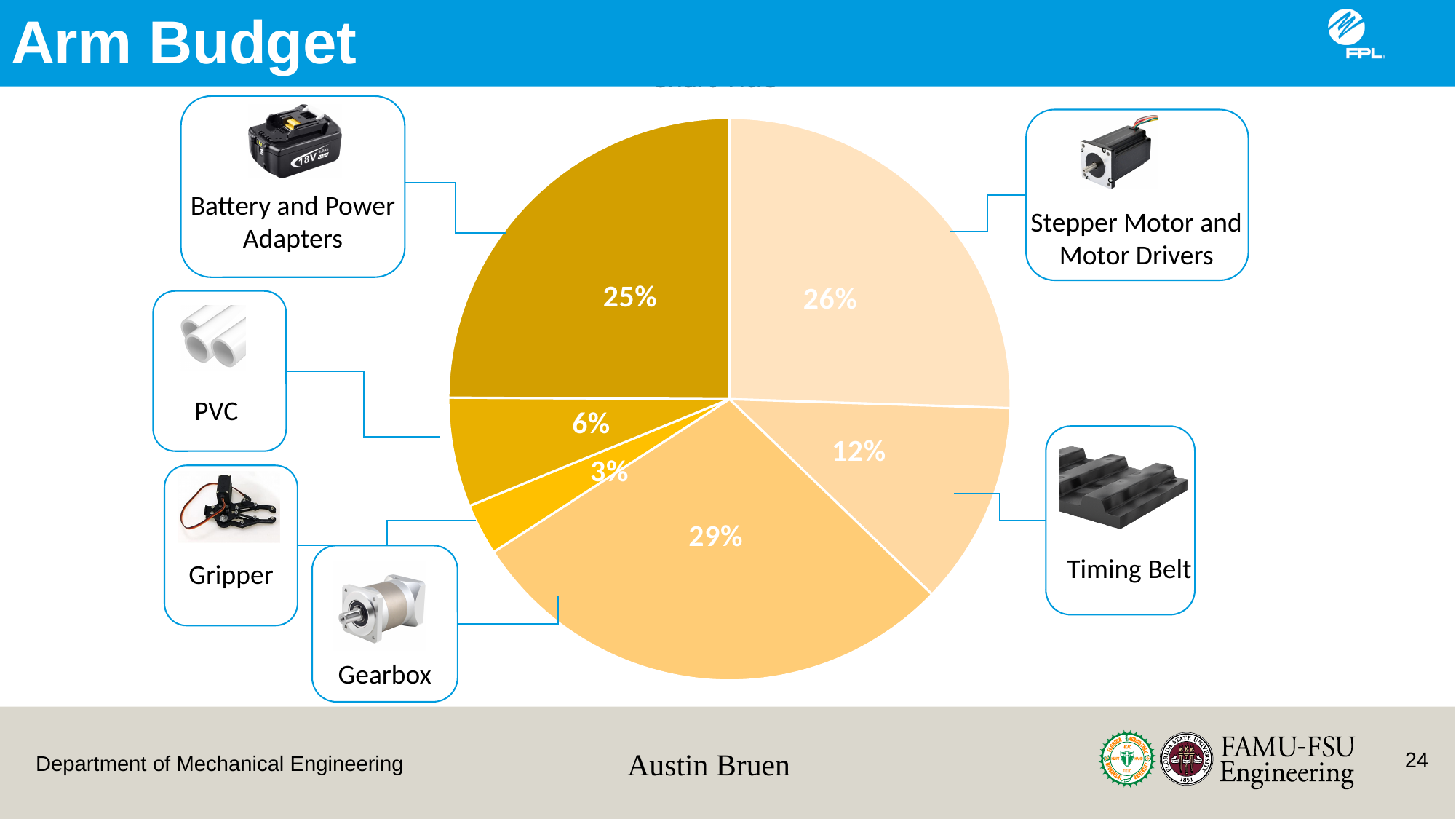
What share of the arm budget goes to Battery and Power Adapters? 25% How many slices does the pie chart have? 6 What share of the arm budget goes to the Gearbox? 29% What share of the arm budget goes to the Gripper? 3% What is the difference in percentage points between the Gearbox share and the Timing Belt share? 17 What kind of chart is shown on the slide? pie chart Which component takes the smallest share of the arm budget? Gripper Which component takes the largest share of the arm budget? Gearbox Which has the larger share of the budget, PVC or the Gripper? PVC